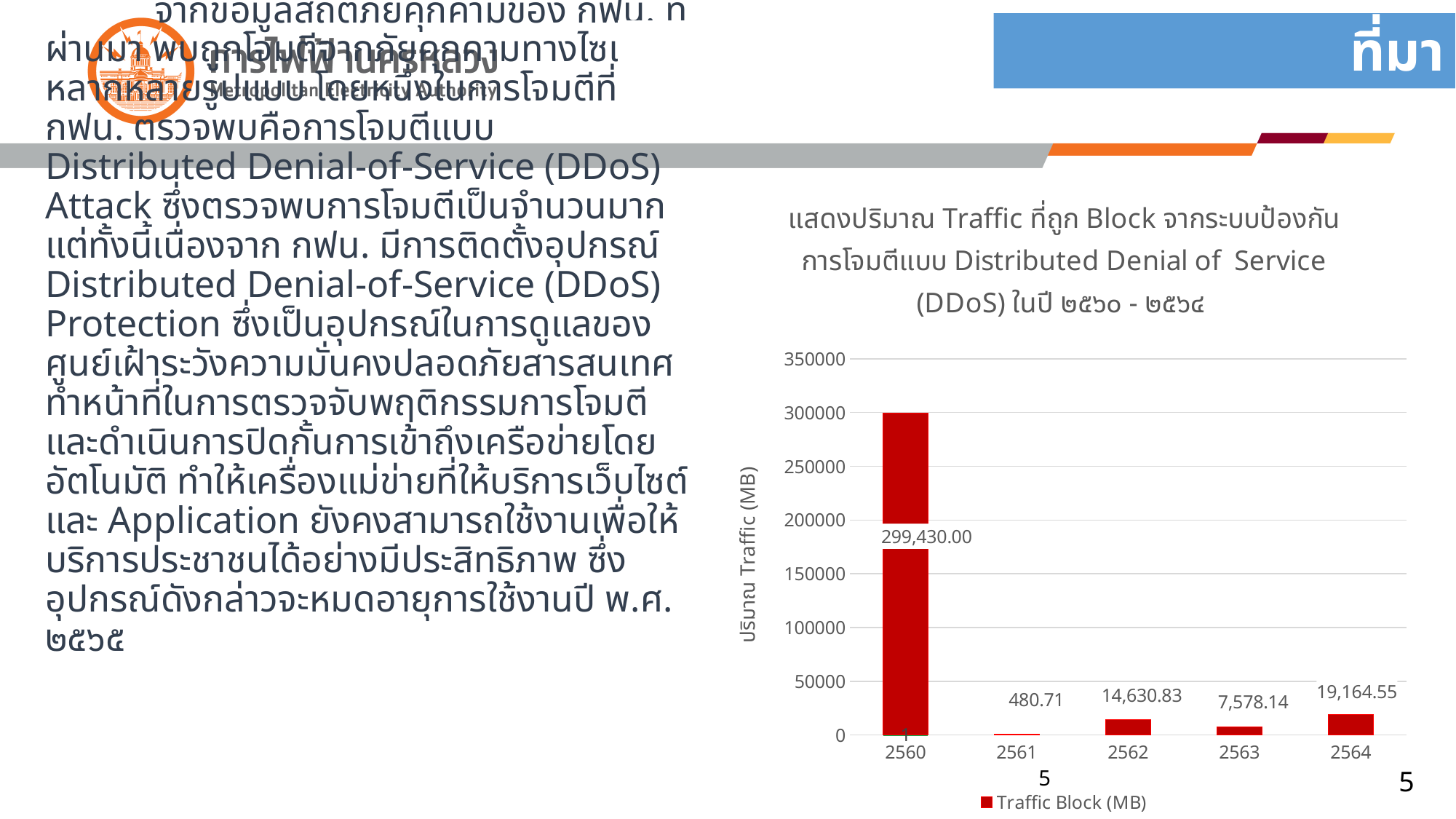
What is the Traffic Block (MB) value for 2561? 480.71 Which year has a larger Traffic Block (MB) value, 2562 or 2563? 2562 What kind of chart is shown on the slide? Bar chart What is the Traffic Block (MB) value for 2563? 7,578.14 What is the Traffic Block (MB) value for 2562? 14,630.83 What is the Traffic Block (MB) value for 2564? 19,164.55 Which year has the highest Traffic Block (MB) value? 2560 How many years are shown on the x axis of the chart? 5 What is the legend entry of the chart? Traffic Block (MB) Which year has the lowest Traffic Block (MB) value? 2561 What is the difference between the Traffic Block (MB) values for 2564 and 2562? 4,533.72 What is the Traffic Block (MB) value for 2560? 299,430.00